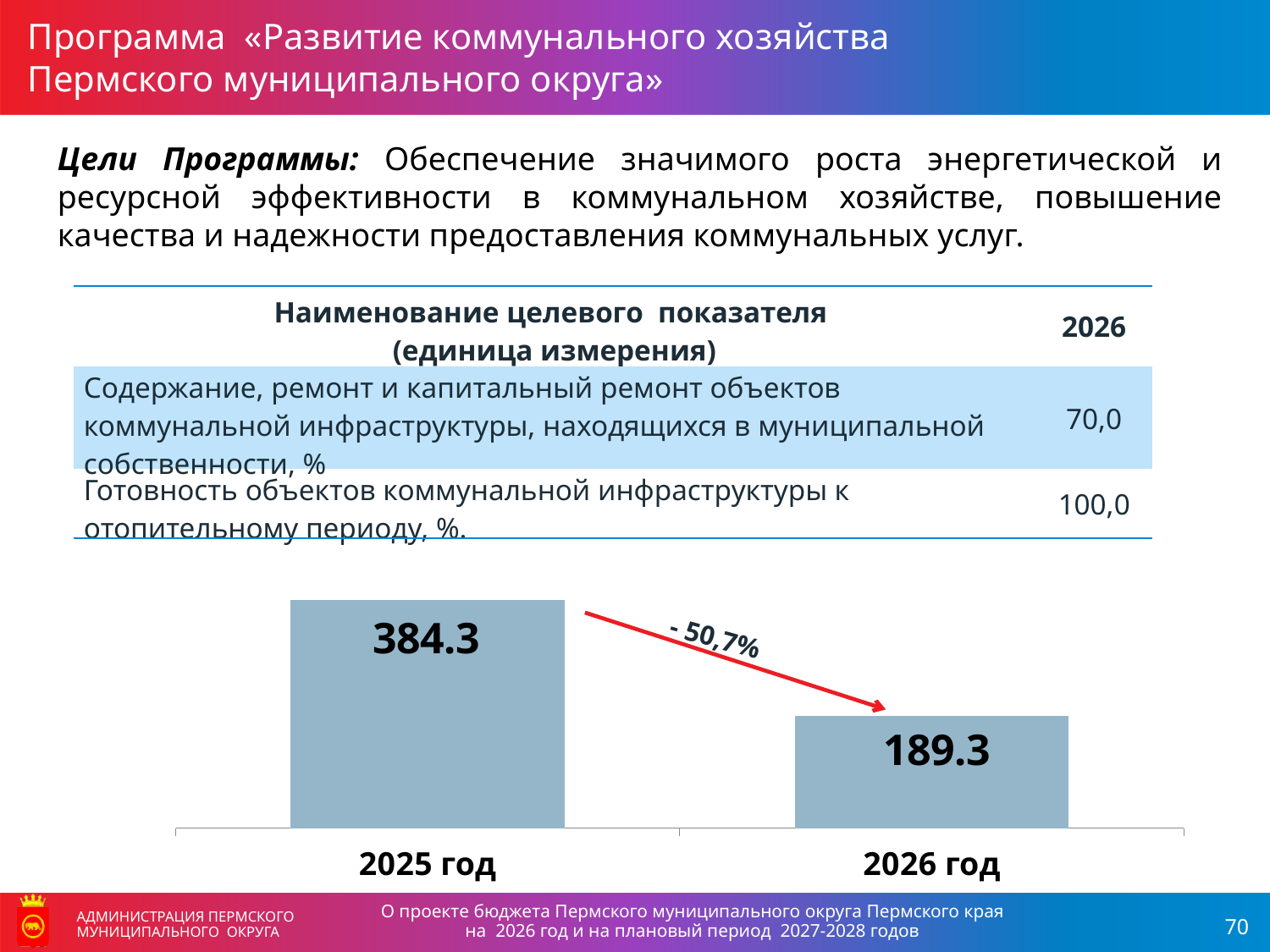
What kind of chart is shown on the slide? Bar chart Do the values in the bar chart rise or fall from 2025 год to 2026 год? Fall What percentage change is written next to the arrow between the two bars? - 50,7% How many bars are shown in the chart? 2 Which is larger in the bar chart: the value for 2025 год or for 2026 год? 2025 год Which year has the highest value in the bar chart? 2025 год Which year has the lowest value in the bar chart? 2026 год What is the value for 2025 год in the bar chart? 384.3 What is the difference between the values for 2025 год and 2026 год in the bar chart? 195.0 What colour is the arrow drawn between the two bars in the chart? Red What is the value for 2026 год in the bar chart? 189.3